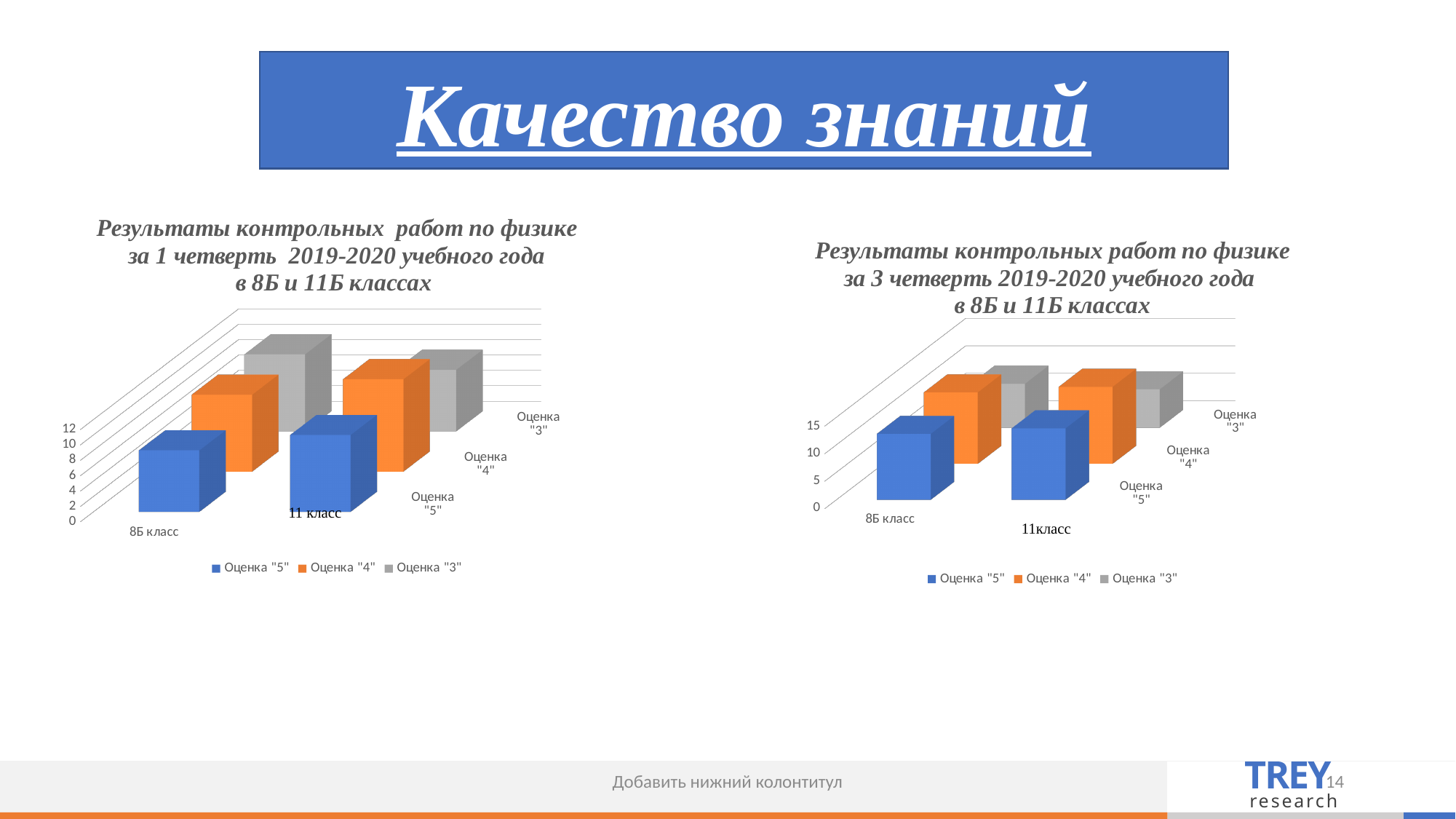
What kind of chart is the right chart, 'Результаты контрольных работ по физике за 3 четверть'? bar chart How many classes (categories) are shown on the x axis of the left chart (1 четверть)? 2 How many series does the legend of the right chart (3 четверть) list? 3 What kind of chart is the left chart, 'Результаты контрольных работ по физике за 1 четверть'? bar chart In the right chart (3 четверть), for 11класс, which is larger: Оценка "4" or Оценка "3"? Оценка "4" How many series does the legend of the left chart (1 четверть) list? 3 In the right chart (3 четверть), for 8Б класс, which series has the lowest value? Оценка "3" In the right chart (3 четверть), for 8Б класс, which is larger: Оценка "5" or Оценка "3"? Оценка "5" In the right chart (3 четверть), which series is shown in grey? Оценка "3" How many classes (categories) are shown on the x axis of the right chart (3 четверть)? 2 In the left chart (1 четверть), which series is shown in blue? Оценка "5" In the left chart (1 четверть), for 8Б класс, which is larger: Оценка "4" or Оценка "5"? Оценка "4"